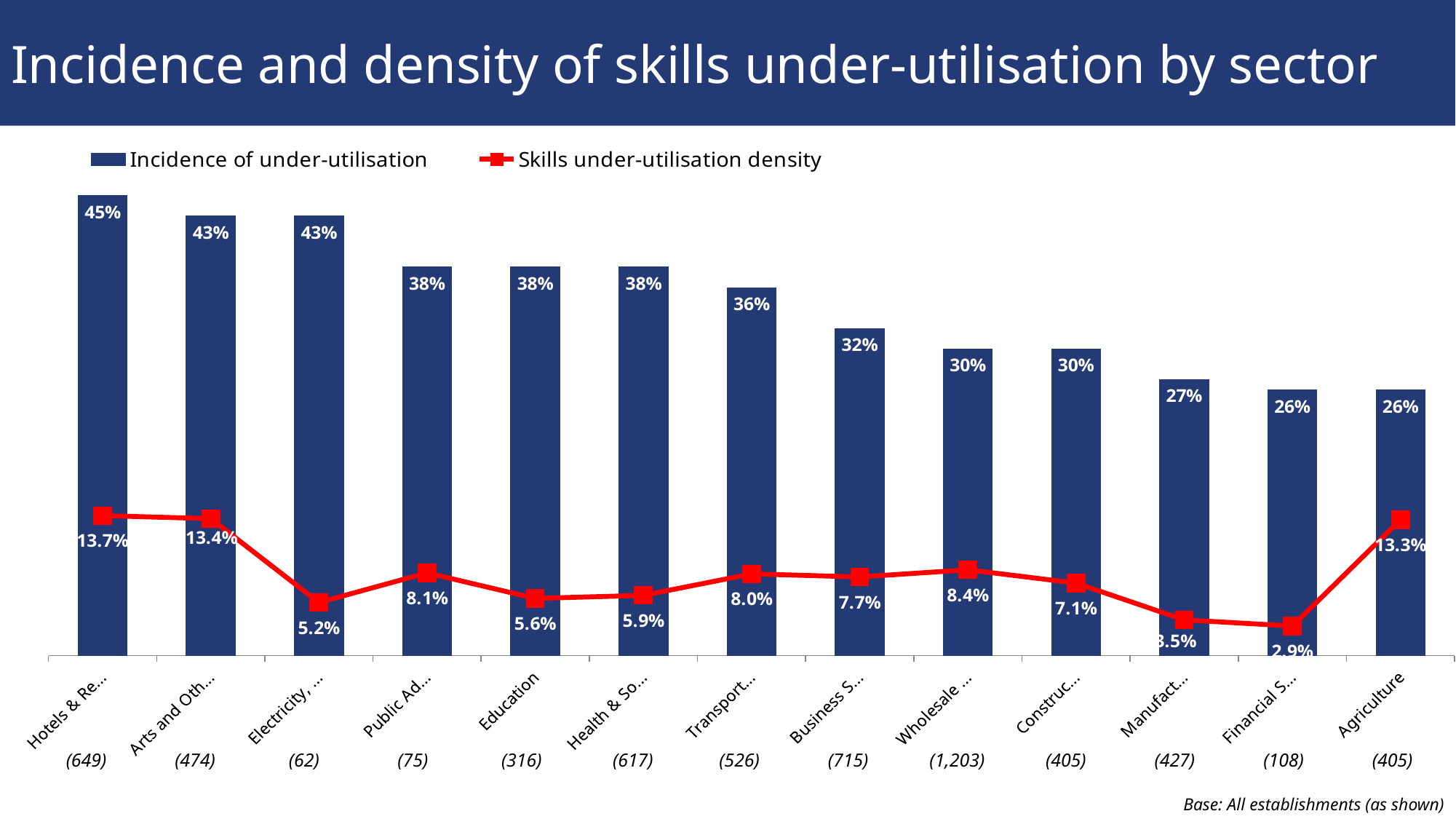
What is the lowest skills under-utilisation density value shown on the chart? 2.9% What is the skills under-utilisation density for Education? 5.6% How many sectors are shown on the x axis? 13 What is the difference in incidence of under-utilisation between Education and Agriculture? 12 percentage points What is the incidence of under-utilisation for Education? 38% Do the incidence of under-utilisation bars rise or fall from left to right across the chart? Fall How many series does the legend list? 2 What is the highest incidence of under-utilisation value shown on the chart? 45% What is the base number of establishments shown for Education? (316) Which has the higher skills under-utilisation density, Education or Agriculture? Agriculture What is the skills under-utilisation density for Agriculture? 13.3% What is the incidence of under-utilisation for Agriculture? 26%